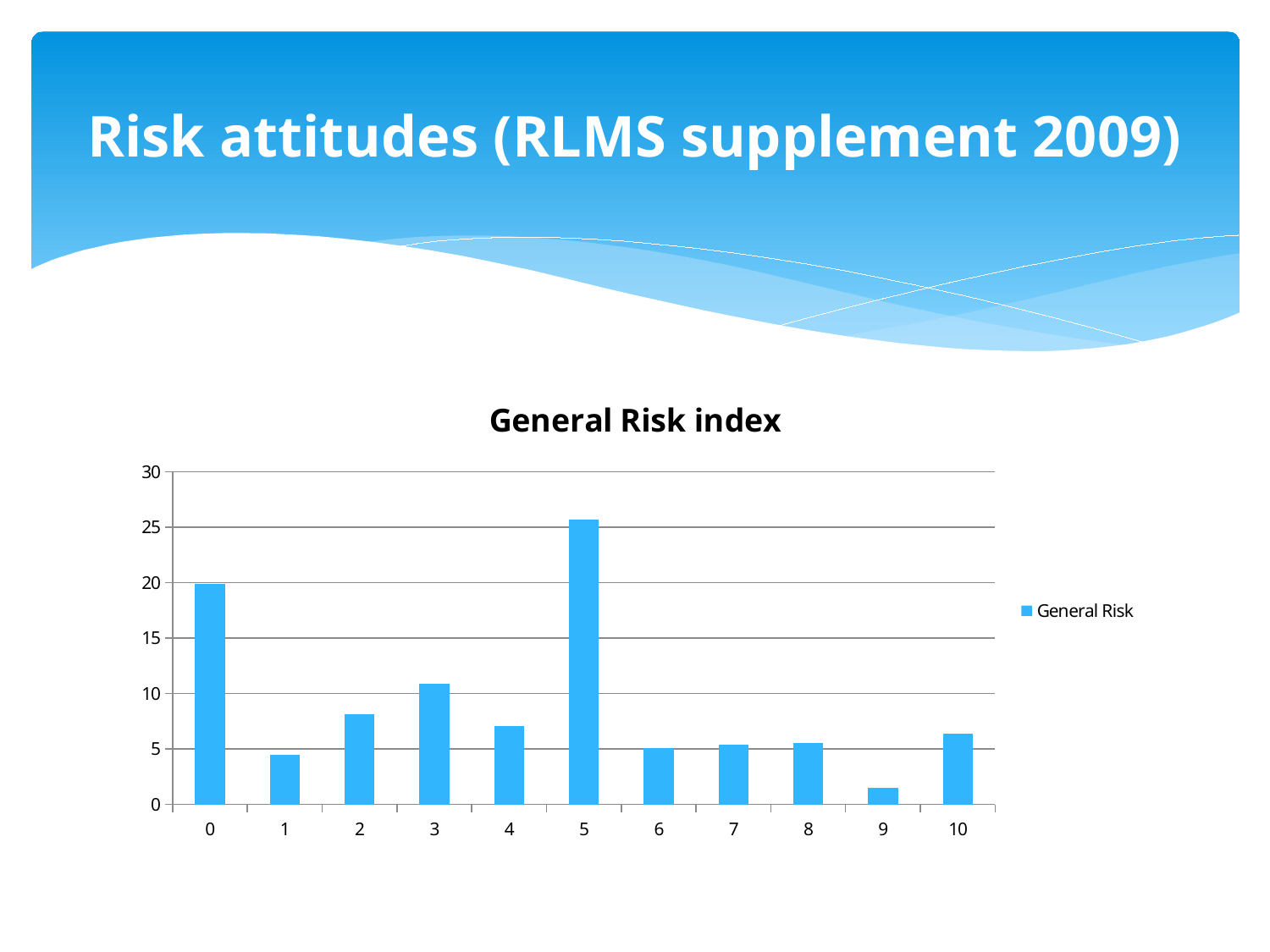
Which has the larger value, category 3 or category 10? 3 How many categories are shown on the x axis? 11 Is the value for category 5 greater or less than 25? greater What is the name of the series shown in the legend? General Risk How many series does the legend list? 1 Which category has the highest value? 5 What is the title of the chart? General Risk index Is the value for category 3 greater or less than 10? greater What type of chart is shown on the slide? bar chart Which category has the lowest value? 9 Is the value for category 9 greater or less than 5? less